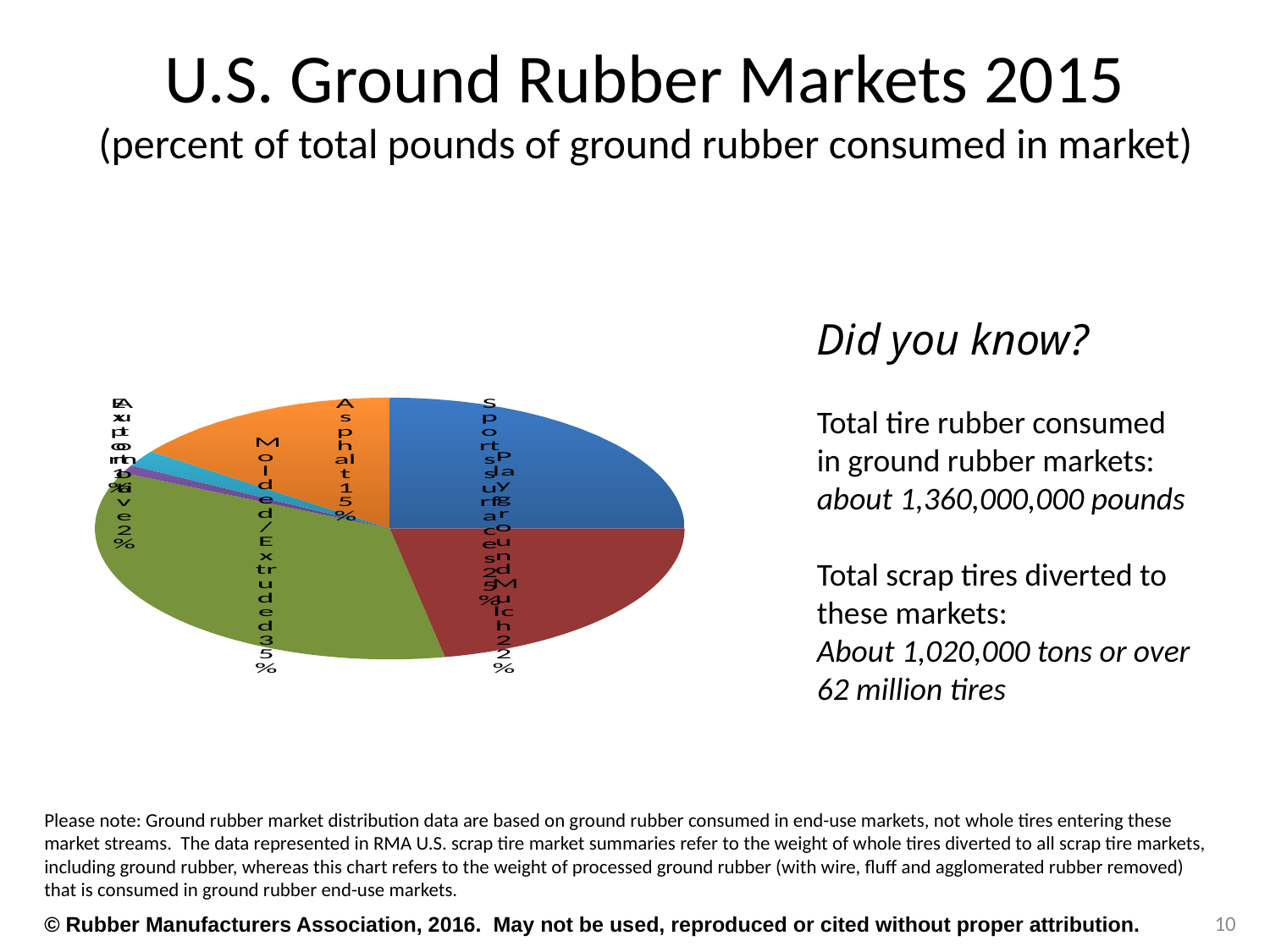
How many percentage points larger is the Sports Surfaces share than the Playground Mulch share? 3 percentage points What percentage of ground rubber consumed goes to the Asphalt market? 15% What percentage of ground rubber consumed goes to the Molded/Extruded market? 35% Which is larger, the share for Molded/Extruded or the share for Asphalt? Molded/Extruded How many percentage points larger is the Molded/Extruded share than the Asphalt share? 20 percentage points What is the title of the chart on the slide? U.S. Ground Rubber Markets 2015 What percentage of ground rubber consumed goes to Sports Surfaces? 25% Which market has the largest share of ground rubber consumed? Molded/Extruded What colour is the Asphalt slice in the pie chart? orange How many slices does the pie chart have? 6 What kind of chart is shown on the slide? pie chart What percentage of ground rubber consumed goes to Playground Mulch? 22%